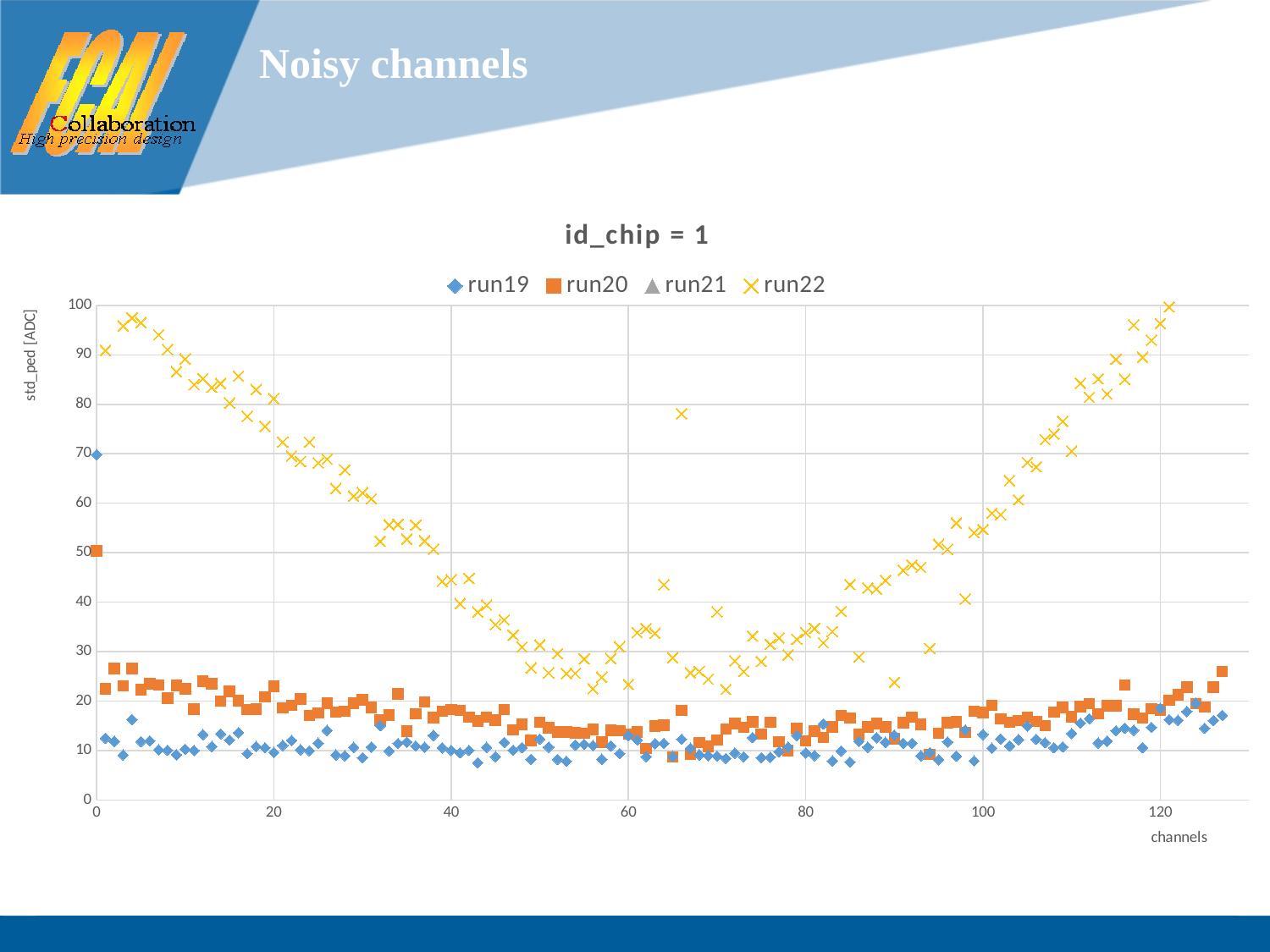
What is the label of the y axis? std_ped [ADC] At channel 0, which series has the higher value, run19 or run20? run19 What kind of chart is shown on the slide? scatter chart Is the value for run20 at channel 0 greater or less than 40? greater Do the run22 values rise or fall from channel 0 to channel 60? fall What is the title of the chart? id_chip = 1 Is the value for run22 at channel 60 greater or less than 40? less Which series has the highest values overall on the chart? run22 How many series does the legend list? 4 Is the value for run19 at channel 0 greater or less than 60? greater At channel 20, which series has the higher value, run22 or run20? run22